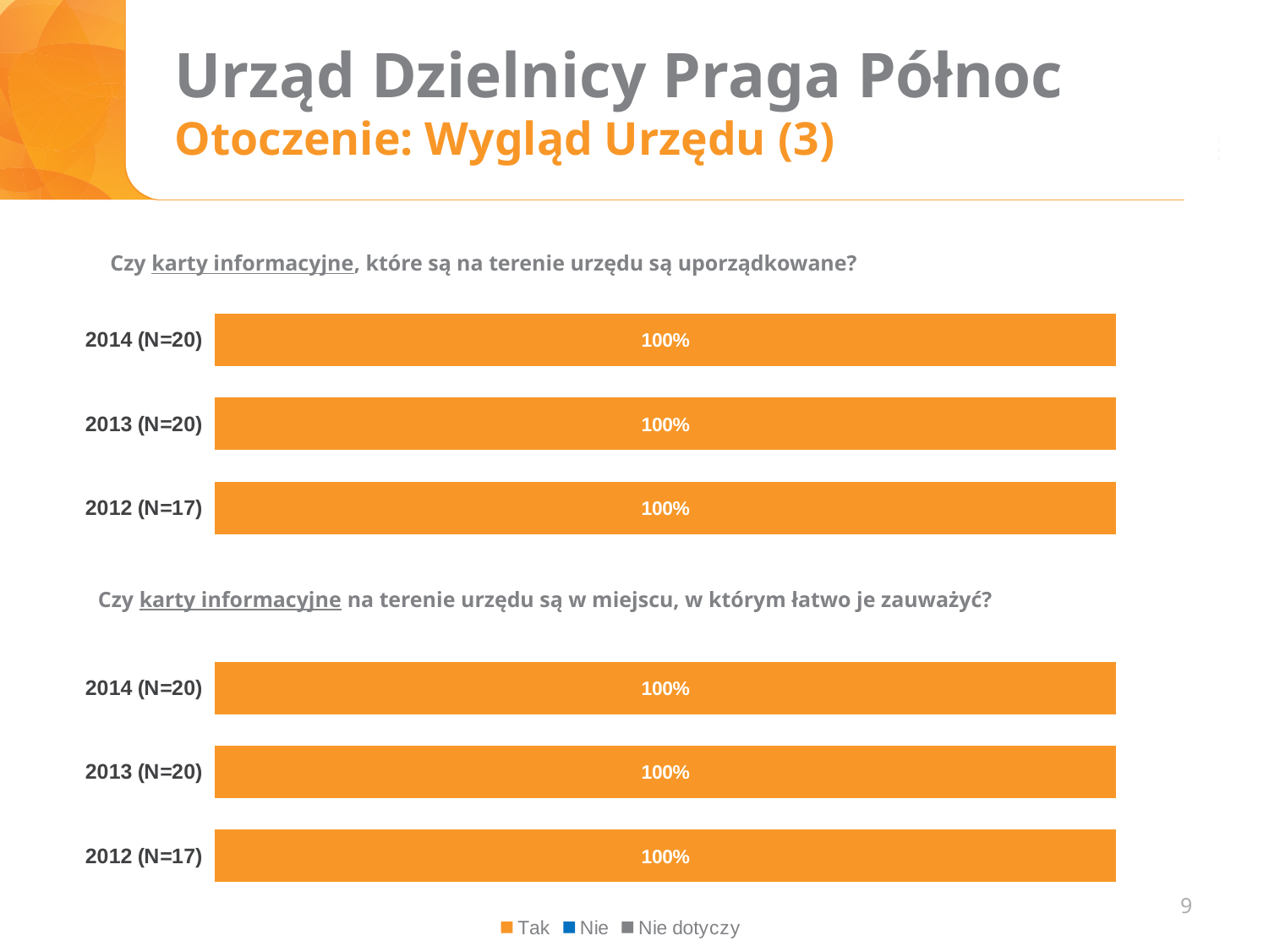
In the bottom chart, what is the difference between the values for 2014 (N=20) and 2013 (N=20)? 0% In the top chart, what is the difference between the values for 2014 (N=20) and 2012 (N=17)? 0% In the top chart (Czy karty informacyjne, które są na terenie urzędu są uporządkowane?), what is the value for 2014 (N=20)? 100% Which legend entry corresponds to the orange bars? Tak How many categories (years) are shown in the top chart? 3 What kind of chart is the top chart? Bar chart In the top chart (Czy karty informacyjne, które są na terenie urzędu są uporządkowane?), what is the value for 2012 (N=17)? 100% In the bottom chart (Czy karty informacyjne na terenie urzędu są w miejscu, w którym łatwo je zauważyć?), what is the value for 2012 (N=17)? 100% How many categories (years) are shown in the bottom chart? 3 In the bottom chart (Czy karty informacyjne na terenie urzędu są w miejscu, w którym łatwo je zauważyć?), what is the value for 2013 (N=20)? 100% In the bottom chart, do the values change from 2012 (N=17) to 2014 (N=20)? No, they stay at 100% How many series does the legend at the bottom of the slide list? 3